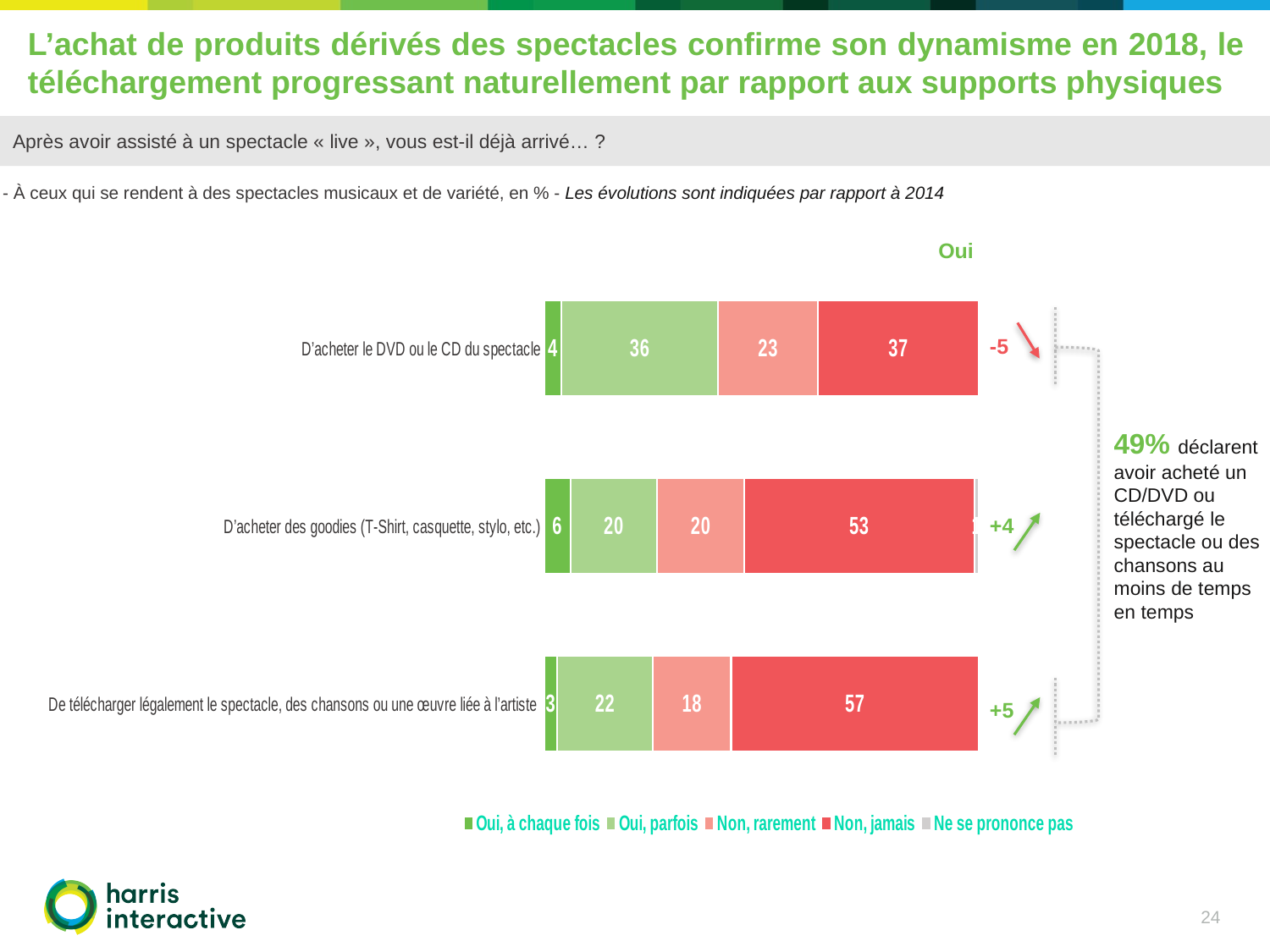
How many series does the legend list? 5 What is the value for "Non, jamais" for "D'acheter le DVD ou le CD du spectacle"? 37 What kind of chart is shown on the slide? Stacked bar chart Which category has the lowest value for "Non, rarement"? De télécharger légalement le spectacle, des chansons ou une œuvre liée à l'artiste What is the difference between the "Non, jamais" values for "De télécharger légalement le spectacle..." and "D'acheter le DVD ou le CD du spectacle"? 20 Which is larger: the "Oui, parfois" value for "D'acheter le DVD ou le CD du spectacle" or for "D'acheter des goodies"? D'acheter le DVD ou le CD du spectacle What is the value for "Oui, à chaque fois" for "De télécharger légalement le spectacle, des chansons ou une œuvre liée à l'artiste"? 3 What evolution compared to 2014 is shown for "Oui" for "D'acheter le DVD ou le CD du spectacle"? -5 What is the value for "Oui, parfois" for "D'acheter des goodies (T-Shirt, casquette, stylo, etc.)"? 20 What is the combined "Oui" total ("Oui, à chaque fois" plus "Oui, parfois") for "D'acheter le DVD ou le CD du spectacle"? 40 Which category has the highest value for "Non, jamais"? De télécharger légalement le spectacle, des chansons ou une œuvre liée à l'artiste How many categories (bars) are plotted in the chart? 3